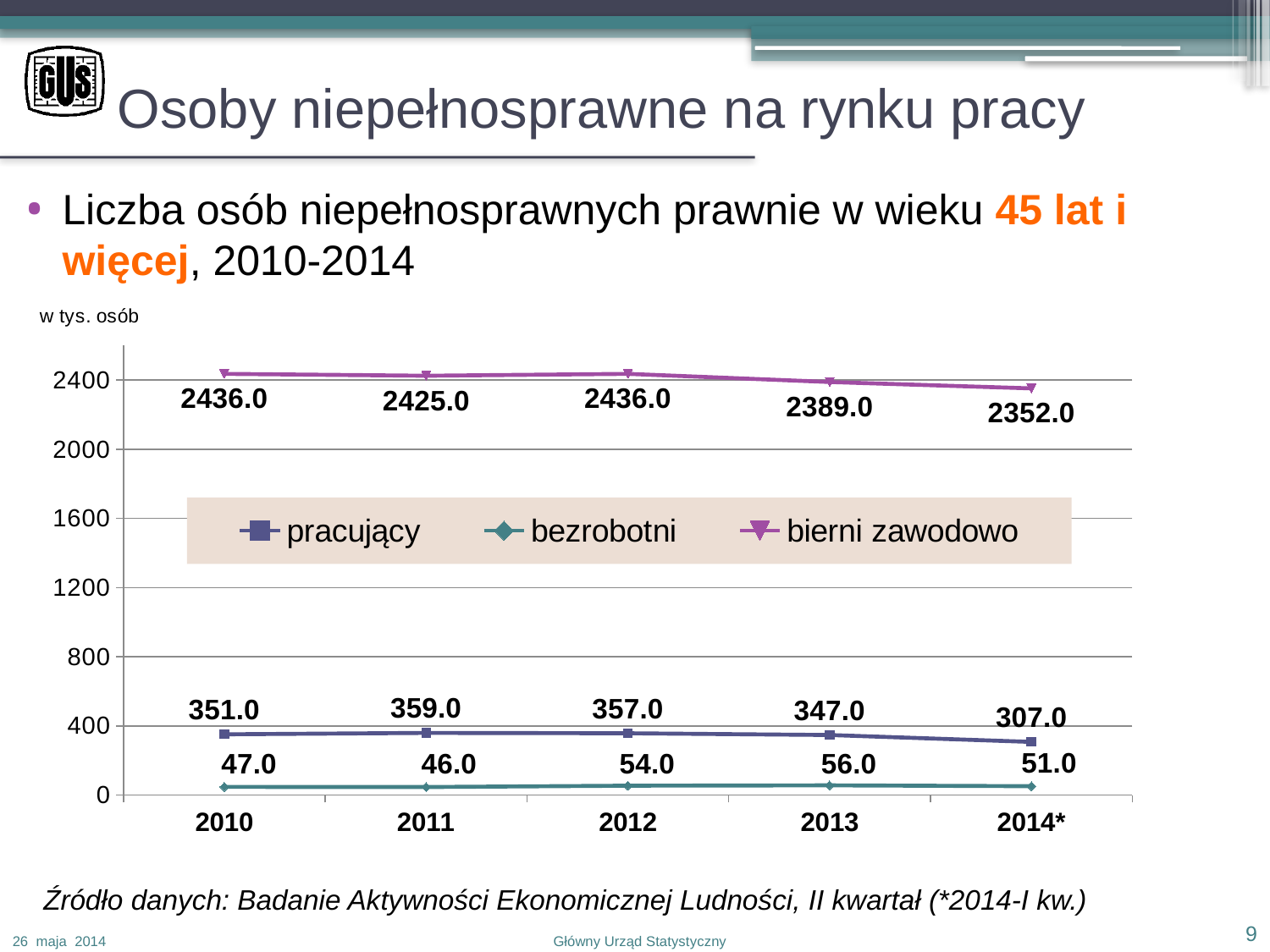
Does the bierni zawodowo series rise or fall from 2012 to 2014*? fall Which is larger, the bezrobotni value for 2012 or for 2011? 2012 In which year is the value for bierni zawodowo lowest? 2014* What unit is stated above the chart's y axis? w tys. osób What kind of chart is shown on the slide? line chart What is the value for pracujący in 2014*? 307.0 What is the value for bezrobotni in 2013? 56.0 What is the difference between the bierni zawodowo values for 2010 and 2014*? 84.0 How many series does the legend list? 3 What is the value for bierni zawodowo in 2010? 2436.0 In which year is the value for pracujący highest? 2011 How many years are shown on the x axis? 5